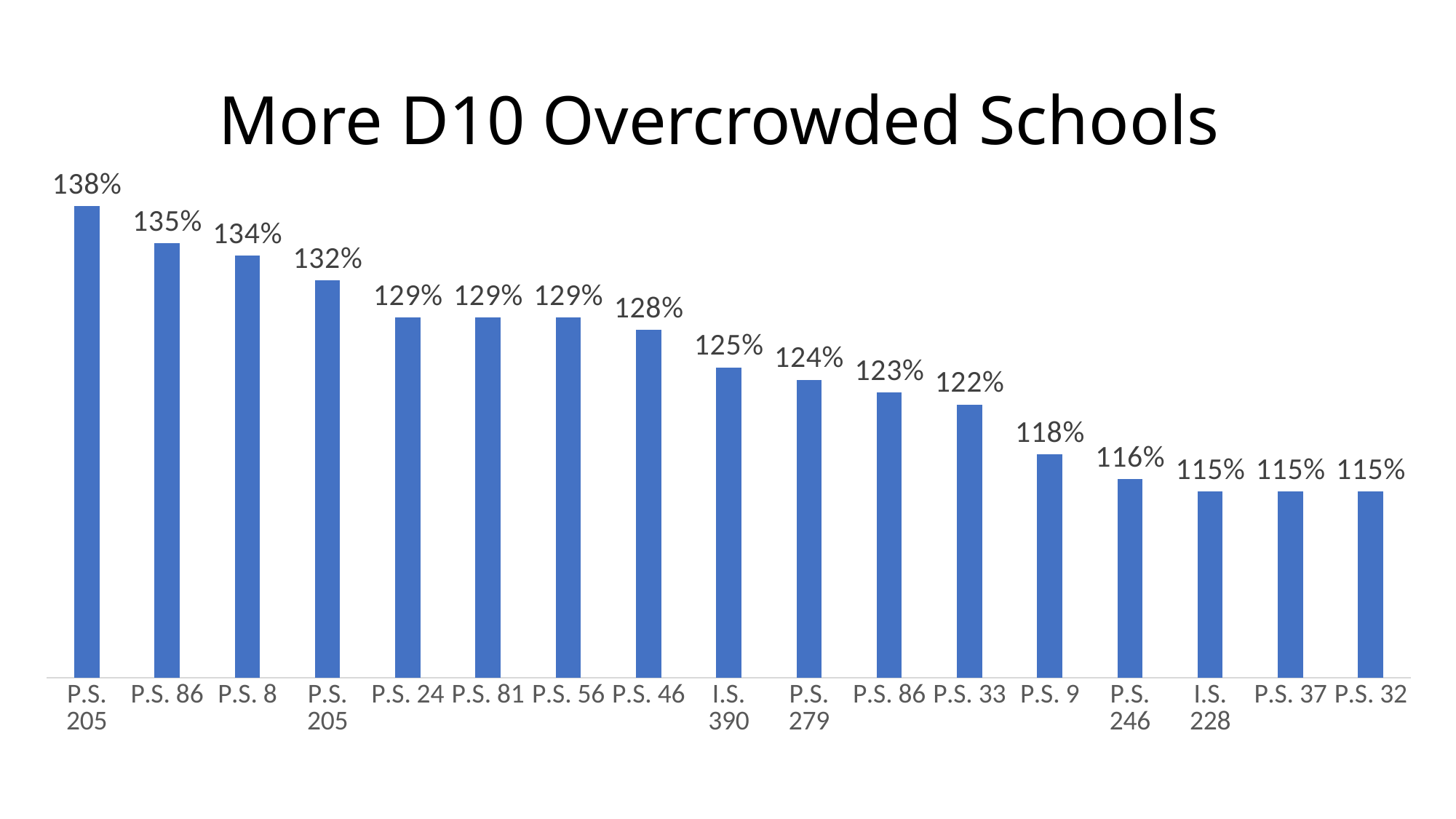
What is the title of the chart? More D10 Overcrowded Schools Which has a larger value, P.S. 24 or P.S. 279? P.S. 24 What is the value for I.S. 390? 125% Which school has the highest value in the chart? P.S. 205 What type of chart is shown on the slide? bar chart What is the value for P.S. 8? 134% Do the values generally rise or fall from left to right across the chart? fall What is the value for P.S. 246? 116% What is the value for P.S. 9? 118% How many bars are plotted in the chart? 17 What is the difference between the values for P.S. 8 and P.S. 33? 12% What is the value for P.S. 46? 128%